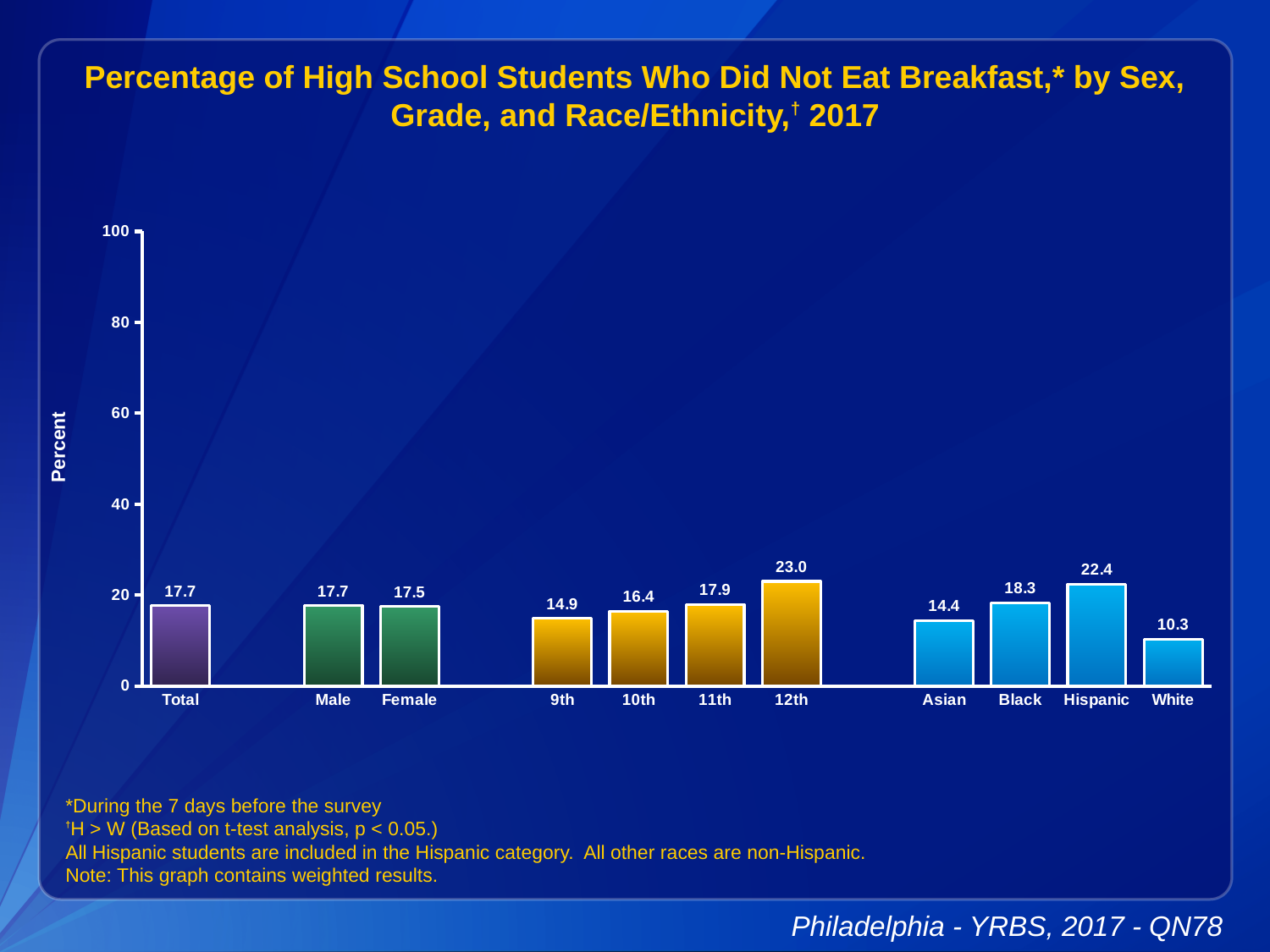
What is the value for Asian? 14.4 What is the difference between the values for 12th and 9th grade? 8.1 What kind of chart is shown on the slide? bar chart What is the value for 12th grade? 23.0 Which is larger, the value for Black or the value for Asian? Black What is the difference between the values for Hispanic and White? 12.1 What is the value for Female? 17.5 Is the value for 12th grade greater or less than 20? greater Which category has the highest value? 12th What is the value for Total? 17.7 Which category has the lowest value? White How many categories are shown on the x axis? 11